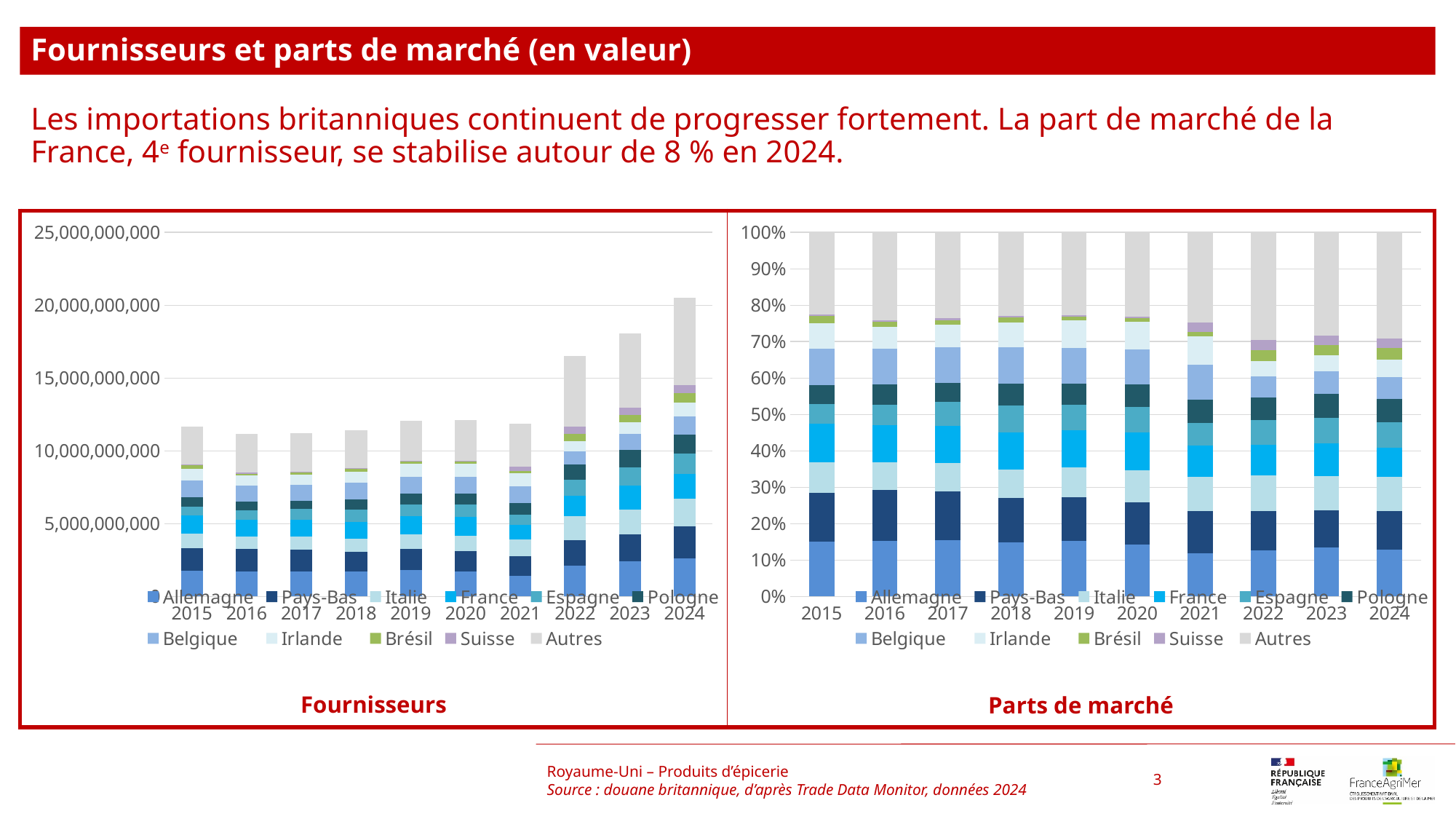
In the 'Parts de marché' chart, is the share of Autres in 2024 greater or less than 20%? greater In the 'Fournisseurs' chart, do the total bars generally rise or fall from 2015 to 2024? Rise In the 'Parts de marché' chart, is the share of Allemagne in 2015 greater or less than 10%? greater How many series does the legend of the 'Parts de marché' chart list? 11 In the 'Fournisseurs' chart, is the total for 2024 greater or less than 20,000,000,000? greater In the 'Fournisseurs' chart, which total bar is larger, 2021 or 2022? 2022 Which series is listed first in the legend of the 'Fournisseurs' chart? Allemagne In the 'Fournisseurs' chart, which year has the tallest total bar? 2024 What kind of chart is the 'Fournisseurs' chart on the left? Stacked bar chart How many years are shown on the x axis of the 'Fournisseurs' chart? 10